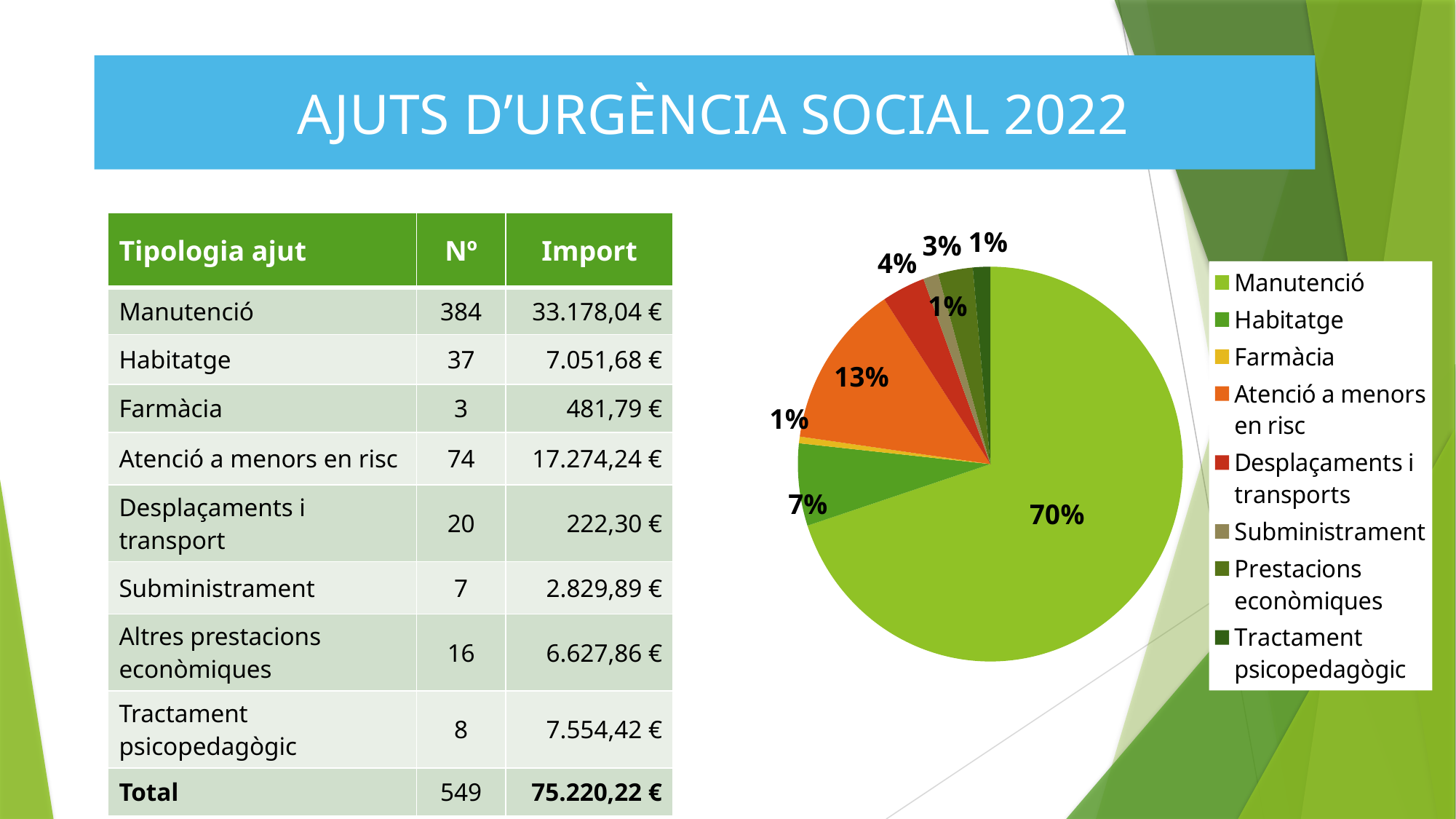
What is the title of the slide containing the pie chart? AJUTS D'URGÈNCIA SOCIAL 2022 Which slice is larger in the pie chart, Habitatge or Atenció a menors en risc? Atenció a menors en risc What percentage of the pie chart does Habitatge represent? 7% How many categories does the legend of the pie chart list? 8 Which category has the largest slice of the pie chart? Manutenció What kind of chart is shown on the slide? pie chart What is the difference in percentage points between the Manutenció slice and the Atenció a menors en risc slice? 57 Which slice is larger in the pie chart, Desplaçaments i transports or Prestacions econòmiques? Desplaçaments i transports What percentage of the pie chart does Atenció a menors en risc represent? 13% What percentage of the pie chart does Prestacions econòmiques represent? 3% What percentage of the pie chart does Desplaçaments i transports represent? 4% What percentage of the pie chart does Manutenció represent? 70%